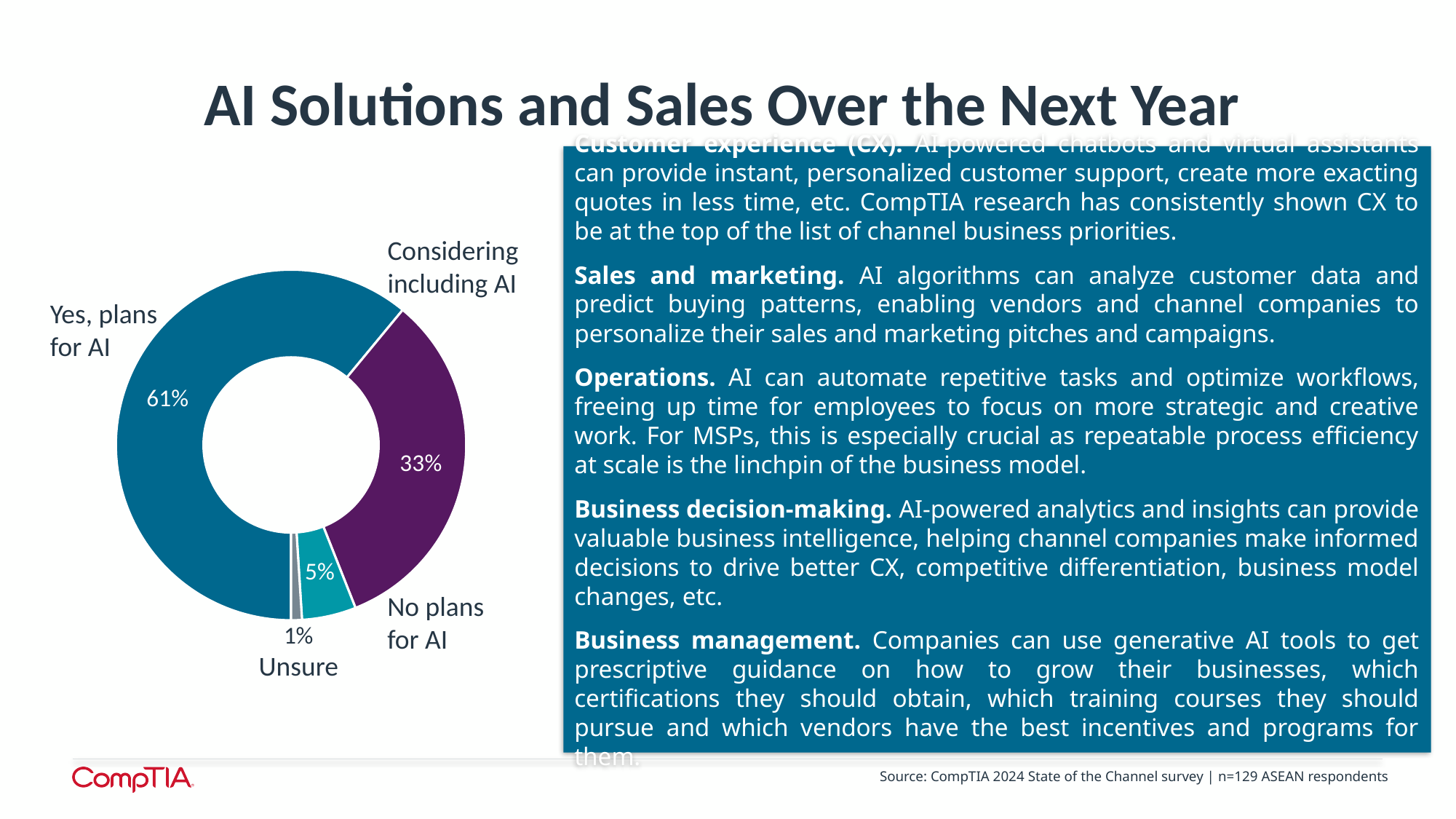
Which is larger: 'No plans for AI' or 'Unsure'? No plans for AI What is the difference in percentage points between 'Yes, plans for AI' and 'Considering including AI'? 28 What colour is the 'Considering including AI' slice? Purple What percentage of respondents are 'Unsure'? 1% How many categories are shown in the chart? 4 What percentage of respondents have 'No plans for AI'? 5% Which category has the smallest share of the chart? Unsure What percentage of respondents are 'Considering including AI'? 33% What percentage of respondents said 'Yes, plans for AI'? 61% What is the combined share of 'No plans for AI' and 'Unsure'? 6% Which category has the largest share of the chart? Yes, plans for AI What kind of chart is shown on the slide? Pie chart (donut)